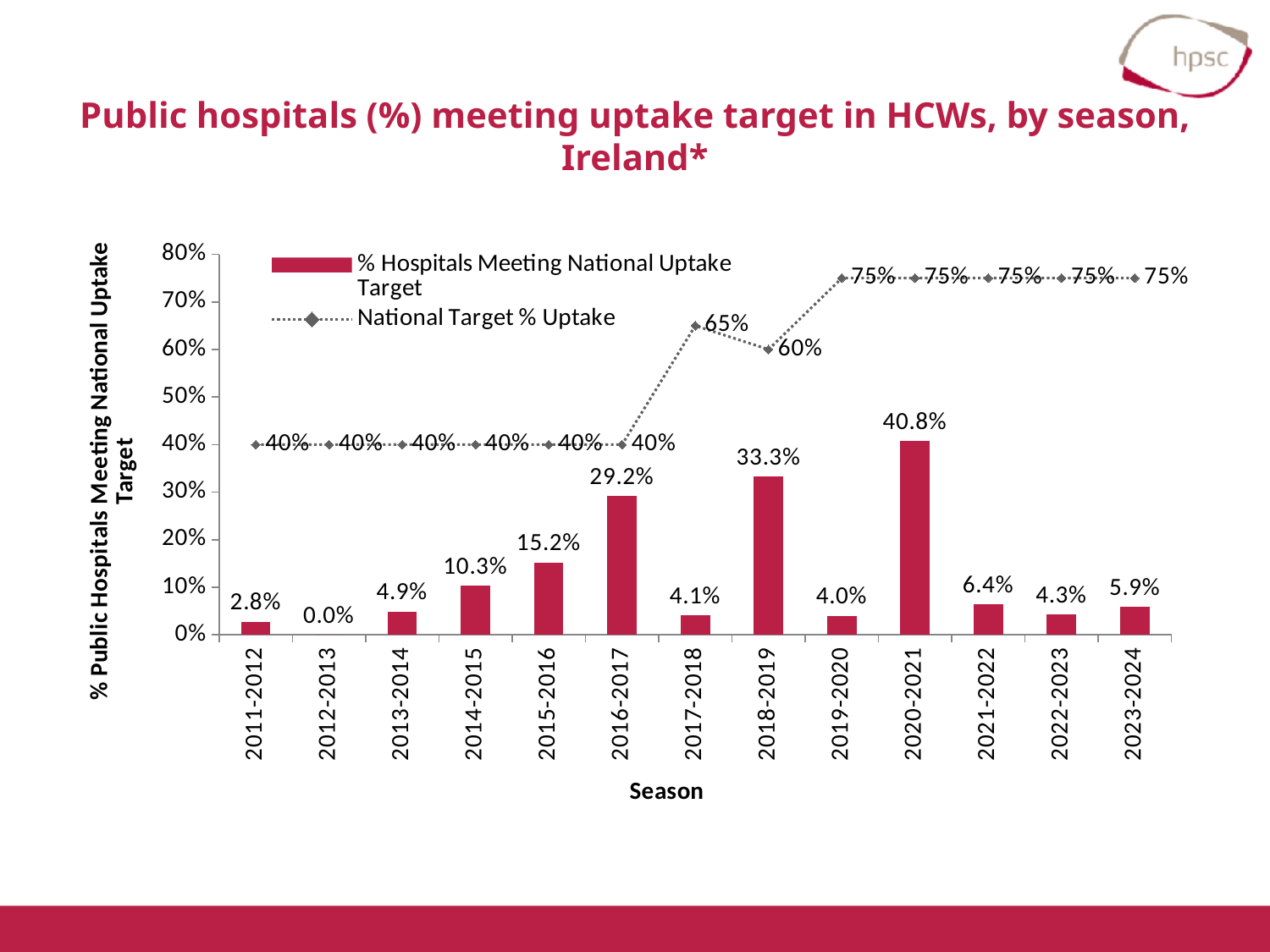
What kind of chart is used to show the % Hospitals Meeting National Uptake Target series? Bar chart What is the difference between the percentage of hospitals meeting the target in 2018-2019 and in 2019-2020? 29.3% What was the National Target % Uptake for the 2017-2018 season? 65% Which season had the lowest percentage of public hospitals meeting the national uptake target? 2012-2013 How many series does the legend list? 2 What percentage of public hospitals met the national uptake target in 2012-2013? 0.0% Did the percentage of hospitals meeting the target rise or fall from 2011-2012 to 2016-2017? Rise Which season had the highest percentage of public hospitals meeting the national uptake target? 2020-2021 What is the label of the x axis? Season What percentage of public hospitals met the national uptake target in the 2020-2021 season? 40.8% Which season had a higher percentage of hospitals meeting the target, 2016-2017 or 2021-2022? 2016-2017 How many seasons are shown on the x axis? 13